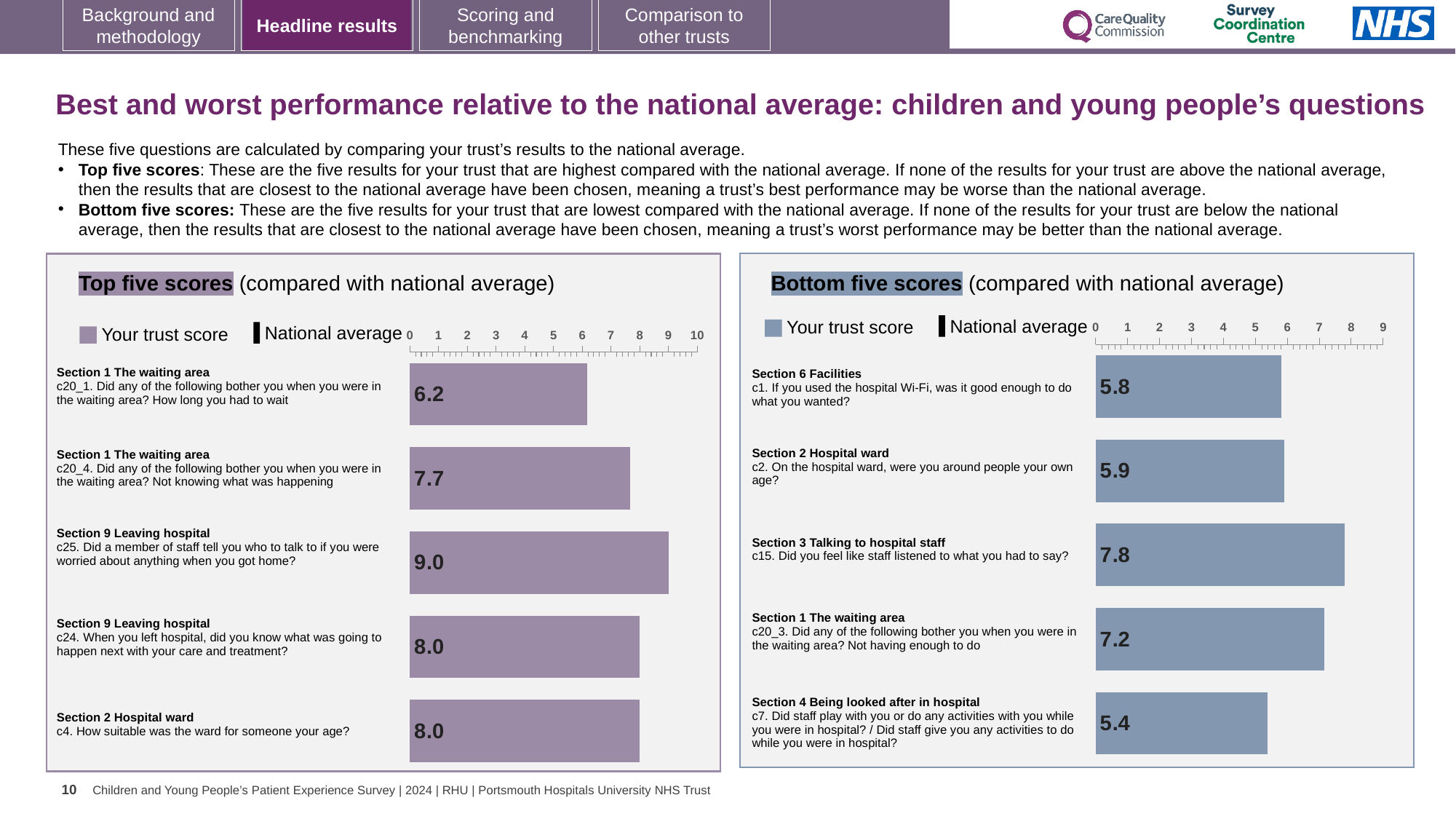
In the Bottom five scores chart, what is the difference between the scores for c15 and c7? 2.4 In the Top five scores chart, what is the trust score for c25 (Did a member of staff tell you who to talk to if you were worried about anything when you got home?)? 9.0 In the Top five scores chart, what is the trust score for c20_1 (How long you had to wait)? 6.2 In the Bottom five scores chart, what is the trust score for c15 (Did you feel like staff listened to what you had to say?)? 7.8 How many series does the legend of the Bottom five scores chart list? 2 In the Bottom five scores chart, which question has the highest trust score? c15. Did you feel like staff listened to what you had to say? In the Bottom five scores chart, which question has the lowest trust score? c7. Did staff play with you or do any activities with you while you were in hospital? In the Top five scores chart, what is the difference between the scores for c25 and c20_4? 1.3 In the Bottom five scores chart, is the score for c2 (On the hospital ward, were you around people your own age?) larger than the score for c1 (hospital Wi-Fi)? Yes, 5.9 vs 5.8 In the Top five scores chart, which question has the lowest trust score? c20_1. How long you had to wait In the Top five scores chart, how many questions are plotted? 5 What type of chart is used in the Top five scores panel? Bar chart